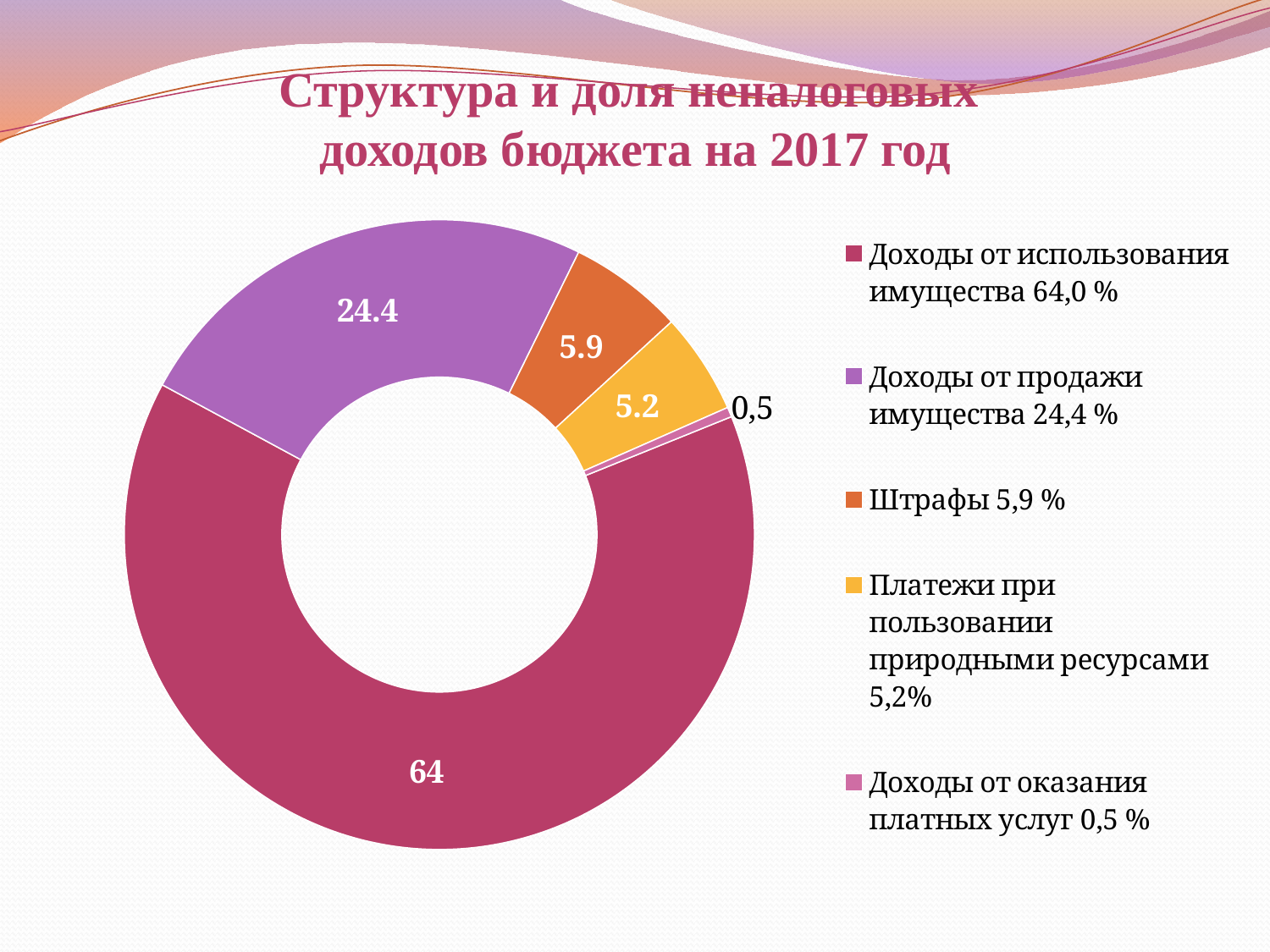
What value is shown for the slice 'Платежи при пользовании природными ресурсами'? 5.2 Which is larger: the value for 'Штрафы' or the value for 'Платежи при пользовании природными ресурсами'? Штрафы What is the difference between the values for 'Доходы от использования имущества' and 'Доходы от продажи имущества'? 39.6 What value is shown for the slice 'Штрафы'? 5.9 How many categories are shown in the chart? 5 Which category has the smallest slice in the chart? Доходы от оказания платных услуг What kind of chart is shown on the slide? doughnut chart Which category has the largest slice in the chart? Доходы от использования имущества What is the title of the slide? Структура и доля неналоговых доходов бюджета на 2017 год What value is shown for the slice 'Доходы от оказания платных услуг'? 0,5 What value is shown for the slice 'Доходы от использования имущества'? 64 What value is shown for the slice 'Доходы от продажи имущества'? 24.4